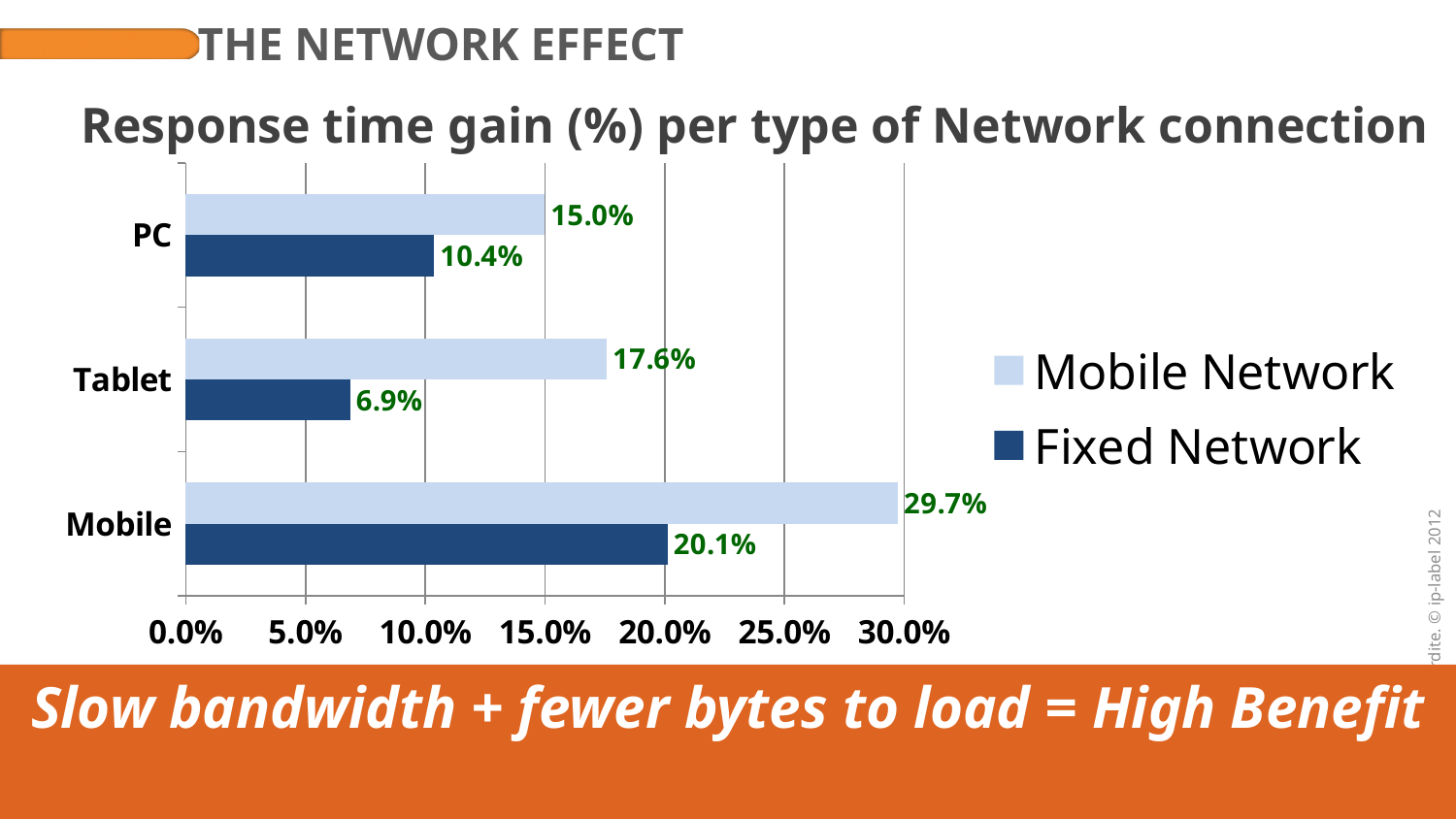
What is the Fixed Network response time gain for Tablet? 6.9% Which category has the highest Mobile Network response time gain? Mobile How many device categories are shown on the chart? 3 What is the Mobile Network response time gain for Mobile? 29.7% Which is larger for PC: the Mobile Network gain or the Fixed Network gain? Mobile Network What is the Mobile Network response time gain for PC? 15.0% What is the Fixed Network response time gain for Mobile? 20.1% Is the Fixed Network value for Mobile greater or less than 15.0%? greater What kind of chart is shown on the slide? Bar chart Which category has the lowest Fixed Network response time gain? Tablet What is the difference between the Mobile Network and Fixed Network response time gains for Tablet? 10.7% How many series does the legend list? 2